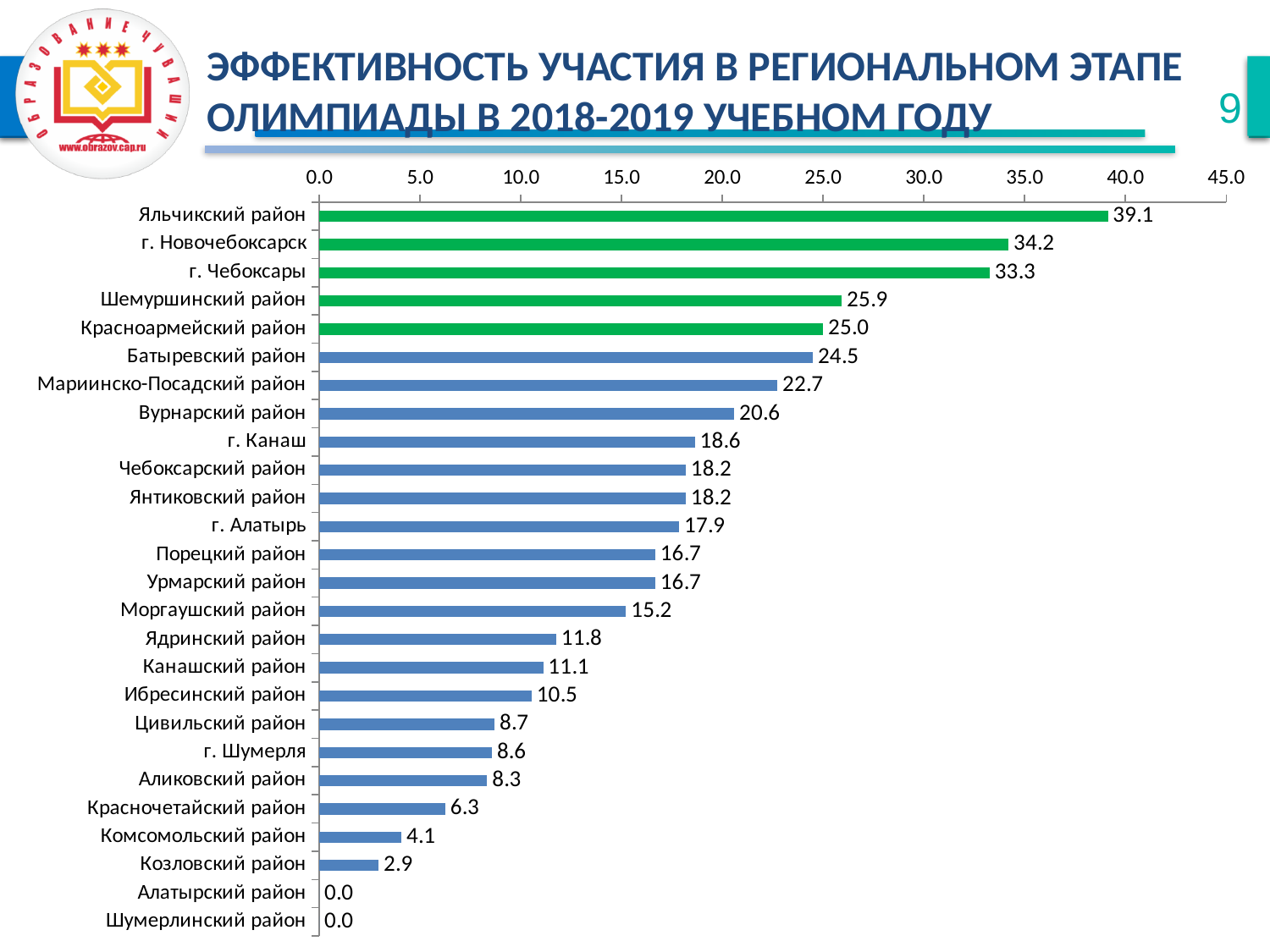
What is the value for Яльчикский район? 39.1 How many categories have a value of 0.0? 2 How many bars are coloured green? 5 What is the value for Вурнарский район? 20.6 What is the difference between the values for Яльчикский район and Красноармейский район? 14.1 What is the value for Козловский район? 2.9 What is the difference between the values for г. Новочебоксарск and г. Чебоксары? 0.9 How many categories are shown in the chart? 26 What is the value for г. Чебоксары? 33.3 Which is larger, the value for Батыревский район or the value for Мариинско-Посадский район? Батыревский район What kind of chart is shown on the slide? Bar chart Which category has the highest value? Яльчикский район